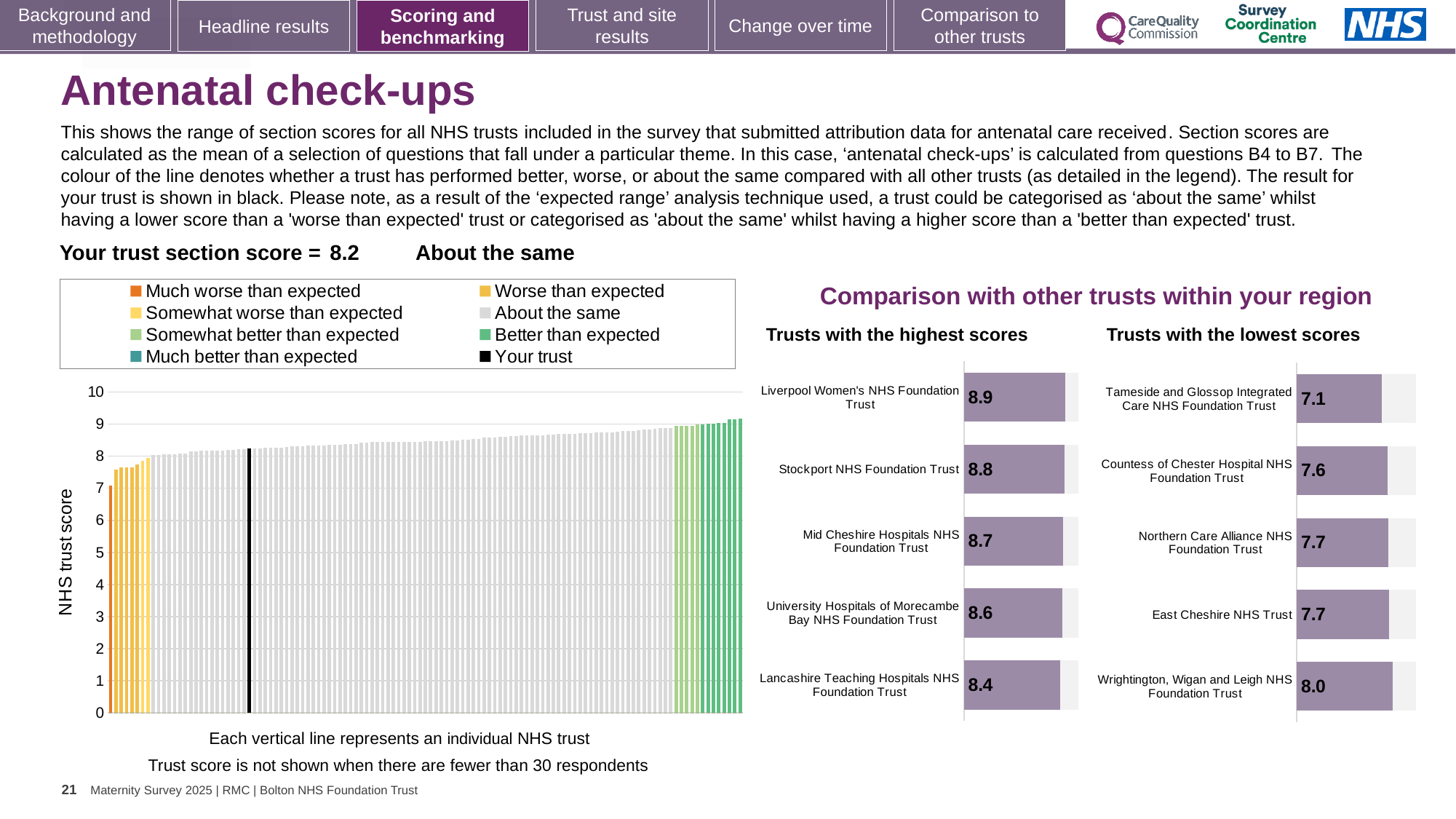
In the 'Trusts with the highest scores' chart, which trust has the lowest score? Lancashire Teaching Hospitals NHS Foundation Trust In the 'Trusts with the lowest scores' chart, what is the difference between the scores of Wrightington, Wigan and Leigh NHS Foundation Trust and Tameside and Glossop Integrated Care NHS Foundation Trust? 0.9 How many entries does the legend of the main chart on the left list? 8 In the 'Trusts with the highest scores' chart, what is the score for Liverpool Women's NHS Foundation Trust? 8.9 In the main chart on the left showing all NHS trusts, what is the section score for your trust (the black bar)? 8.2 In the 'Trusts with the lowest scores' chart, what is the score for Countess of Chester Hospital NHS Foundation Trust? 7.6 In the 'Trusts with the lowest scores' chart, which trust has the highest score? Wrightington, Wigan and Leigh NHS Foundation Trust How many trusts are shown in the 'Trusts with the lowest scores' chart? 5 In the 'Trusts with the lowest scores' chart, which trust has the lowest score? Tameside and Glossop Integrated Care NHS Foundation Trust In the 'Trusts with the highest scores' chart, which has the higher score: Mid Cheshire Hospitals NHS Foundation Trust or University Hospitals of Morecambe Bay NHS Foundation Trust? Mid Cheshire Hospitals NHS Foundation Trust In the main chart on the left showing all NHS trusts, do the bar values rise or fall from left to right? rise In the 'Trusts with the highest scores' chart, what is the difference between the scores of Liverpool Women's NHS Foundation Trust and Lancashire Teaching Hospitals NHS Foundation Trust? 0.5